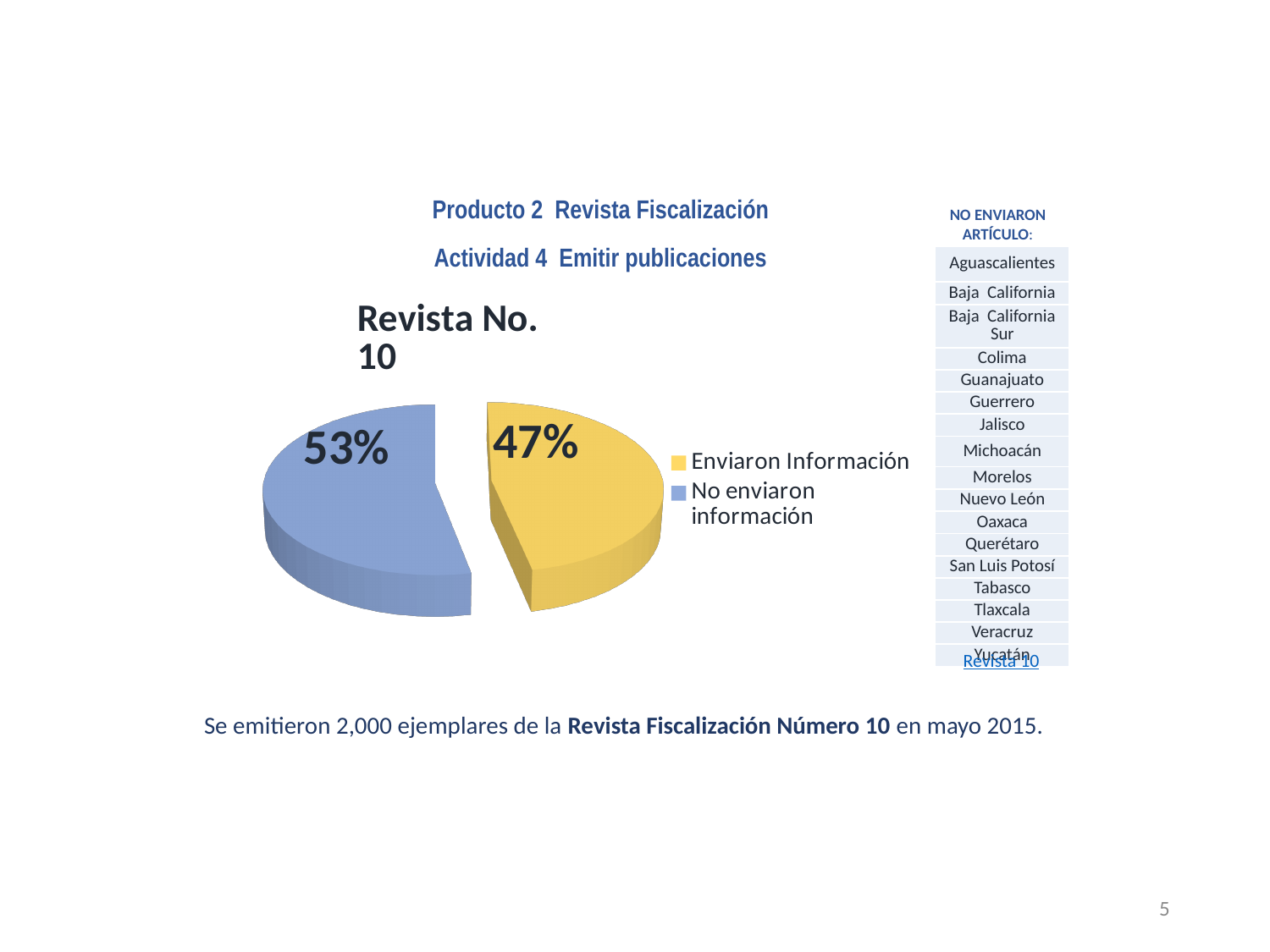
What share of the pie is labelled "No enviaron información"? 53% Which is larger, the share for "Enviaron Información" or for "No enviaron información"? No enviaron información What is the difference in percentage points between the "No enviaron información" and "Enviaron Información" slices? 6% What kind of chart is shown on the slide? pie chart What is the chart's title? Revista No. 10 Which slice is the largest? No enviaron información How many entries does the legend list? 2 What colour is the "Enviaron Información" slice? yellow What share of the pie is labelled "Enviaron Información"? 47% How many slices does the pie chart have? 2 Which slice is the smallest? Enviaron Información Is the share for "Enviaron Información" greater or less than 50%? less